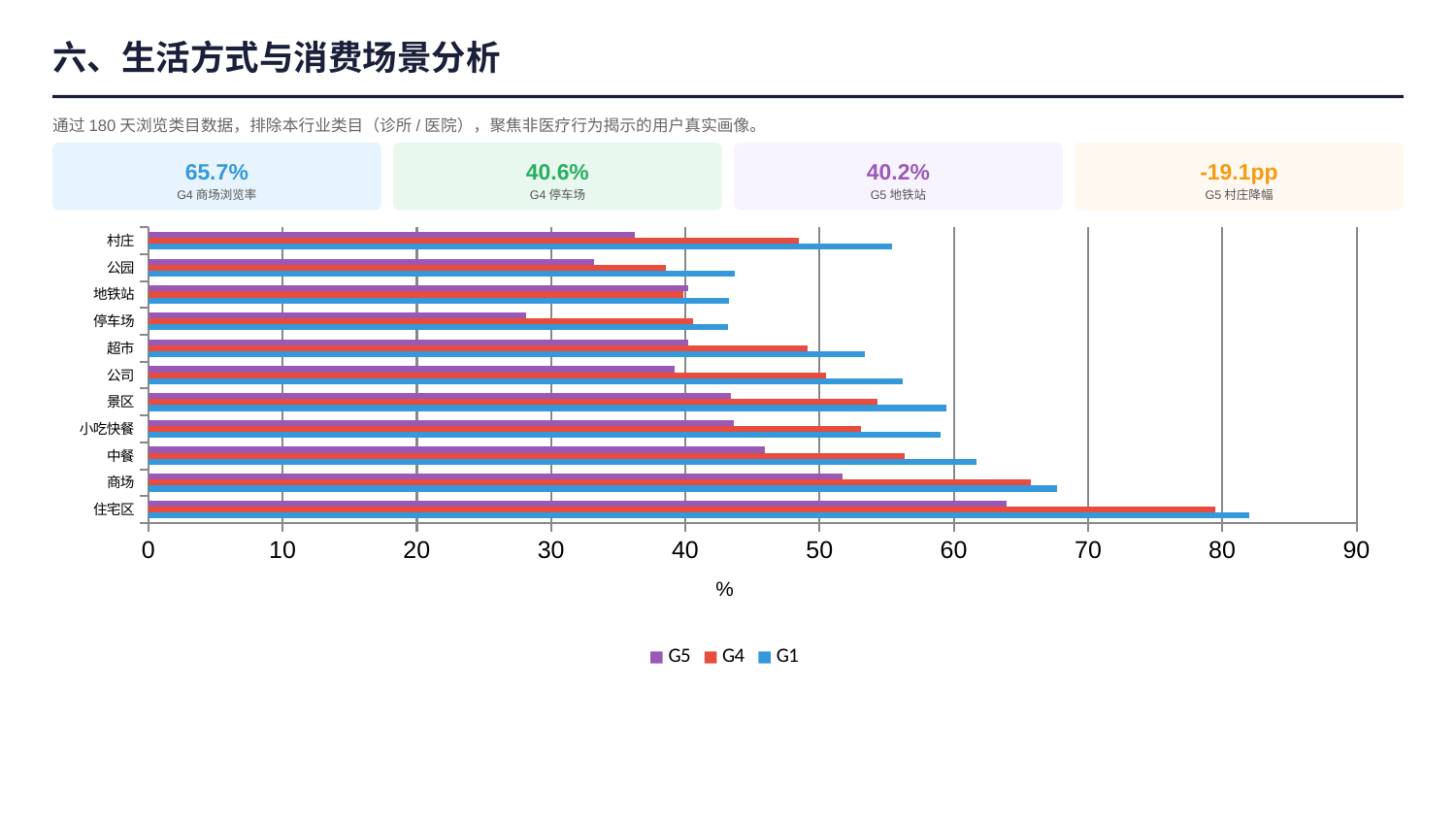
Is the G4 value for 公园 greater or less than 40? less Is the G1 value for 住宅区 greater or less than 70? greater Which is larger, the G4 value for 商场 or the G4 value for 中餐? 商场 Is the G5 value for 停车场 greater or less than 30? less What unit is labelled on the horizontal axis of the chart? % How many categories are shown on the vertical axis of the chart? 11 Which is larger, the G1 value for 村庄 or the G1 value for 公园? 村庄 Which category has the lowest G5 value? 停车场 Which category has the highest G5 value? 住宅区 Which category has the highest G1 value? 住宅区 How many series does the chart legend list? 3 What kind of chart is shown on the slide? bar chart